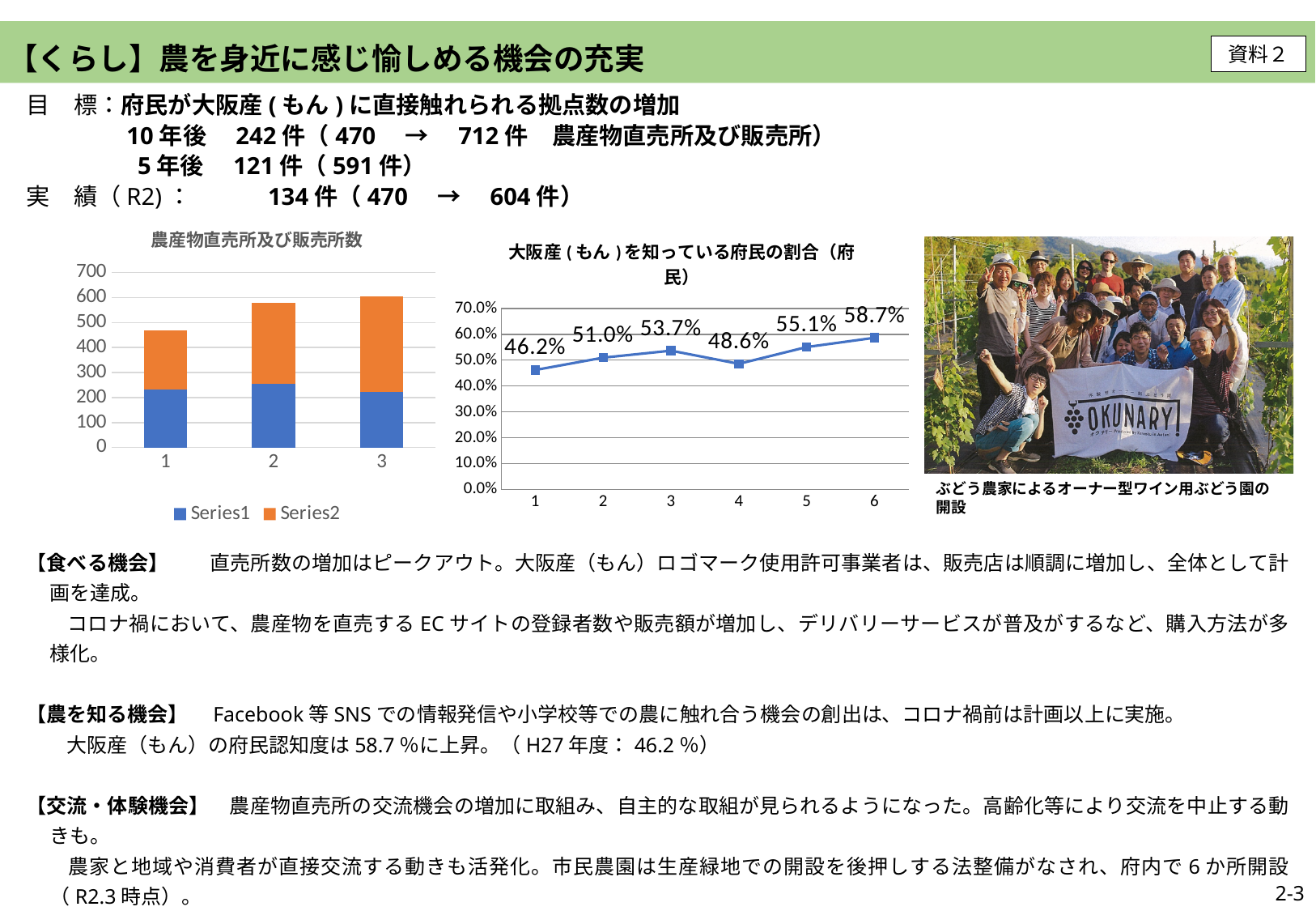
In the chart titled 大阪産(もん)を知っている府民の割合, what is the value at point 6? 58.7% What kind of chart is the chart titled 大阪産(もん)を知っている府民の割合? Line chart In the chart titled 大阪産(もん)を知っている府民の割合, what is the value at point 1? 46.2% In the chart titled 農産物直売所及び販売所数, how many series does the legend list? 2 In the chart titled 大阪産(もん)を知っている府民の割合, how many data points are plotted? 6 In the chart titled 大阪産(もん)を知っている府民の割合, which point has the lowest value? 1 In the chart titled 大阪産(もん)を知っている府民の割合, which is larger, the value at point 3 or the value at point 4? Point 3 In the chart titled 農産物直売所及び販売所数, is the total height of the bar for category 3 greater or less than 500? greater In the chart titled 大阪産(もん)を知っている府民の割合, what is the difference between the values at point 6 and point 1? 12.5% What kind of chart is the chart titled 農産物直売所及び販売所数? Stacked bar chart In the chart titled 大阪産(もん)を知っている府民の割合, which point has the highest value? 6 In the chart titled 大阪産(もん)を知っている府民の割合, what is the value at point 4? 48.6%